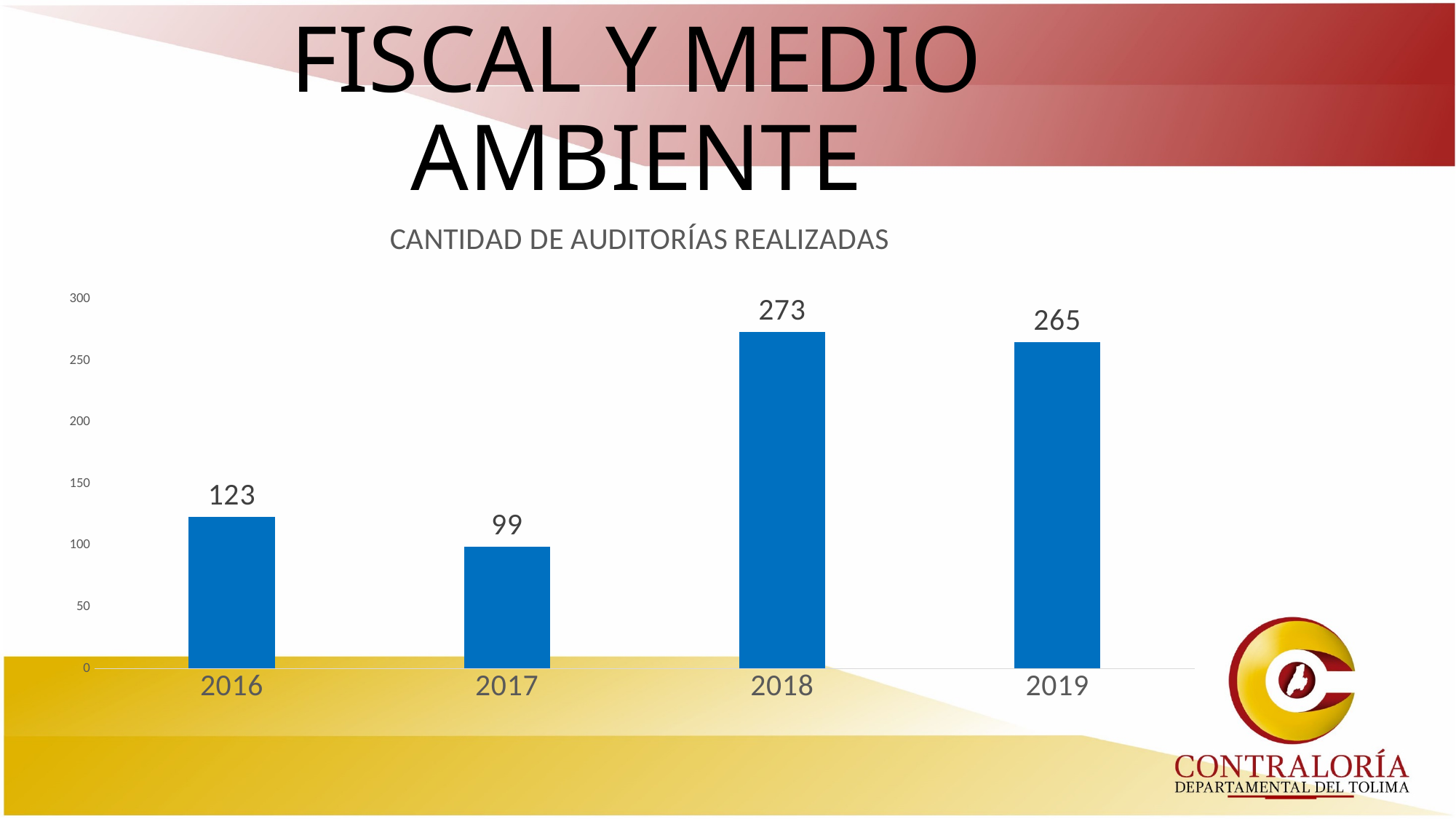
What is the value for 2017? 99 What is the difference between the values for 2018 and 2019? 8 What is the difference between the values for 2016 and 2017? 24 What is the value for 2016? 123 How many years are shown on the chart? 4 Which year has the lowest value? 2017 Which year has the highest value? 2018 What kind of chart is shown? Bar chart What is the value for 2019? 265 What is the title of the chart? CANTIDAD DE AUDITORÍAS REALIZADAS Which is larger, the value for 2016 or the value for 2017? 2016 What is the value for 2018? 273